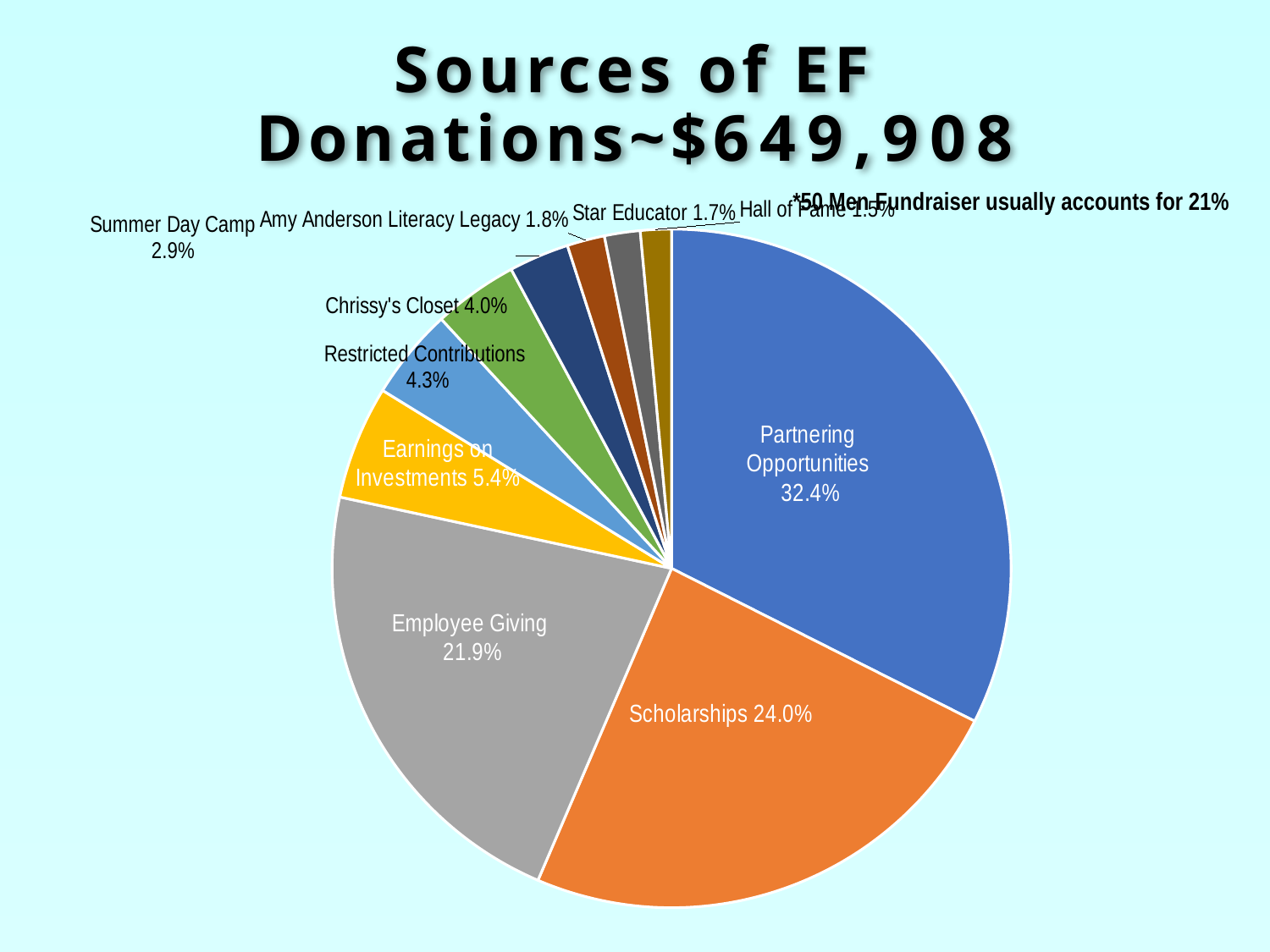
What percentage of the pie is Scholarships? 24.0% What share is labelled for Chrissy's Closet? 4.0% What type of chart is shown on the slide? Pie chart What share of EF donations comes from Partnering Opportunities? 32.4% What percentage is shown for Earnings on Investments? 5.4% What is the title of the chart? Sources of EF Donations~$649,908 How many slices does the pie chart have? 10 How many percentage points larger is the Scholarships share than the Employee Giving share? 2.1 Which source has the smallest slice of the pie? Hall of Fame What share does Employee Giving account for? 21.9% Which source accounts for the largest share of EF donations? Partnering Opportunities Which is larger, the share for Restricted Contributions or the share for Summer Day Camp? Restricted Contributions